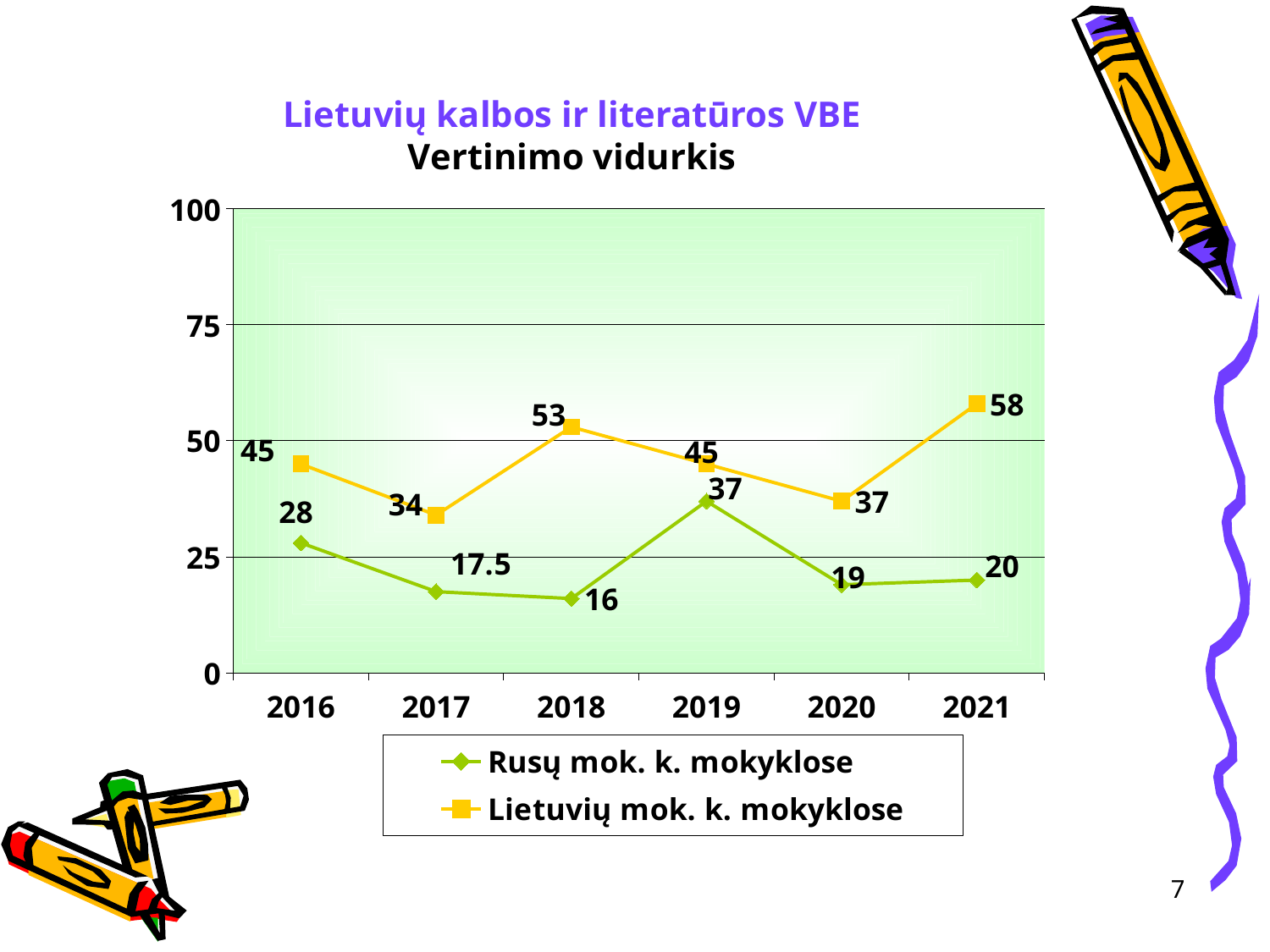
Which series has the larger value in 2020, "Rusų mok. k. mokyklose" or "Lietuvių mok. k. mokyklose"? Lietuvių mok. k. mokyklose How many years are shown on the x axis? 6 What is the value for "Lietuvių mok. k. mokyklose" in 2021? 58 In which year is the value for "Rusų mok. k. mokyklose" lowest? 2018 What type of chart is shown on the slide? line chart What is the value for "Rusų mok. k. mokyklose" in 2017? 17.5 Is the value for "Lietuvių mok. k. mokyklose" in 2018 greater or less than 50? greater How many series does the legend list? 2 What is the difference between the "Lietuvių mok. k. mokyklose" and "Rusų mok. k. mokyklose" values in 2016? 17 What is the title of the chart? Vertinimo vidurkis What is the value for "Rusų mok. k. mokyklose" in 2019? 37 In which year is the value for "Lietuvių mok. k. mokyklose" highest? 2021